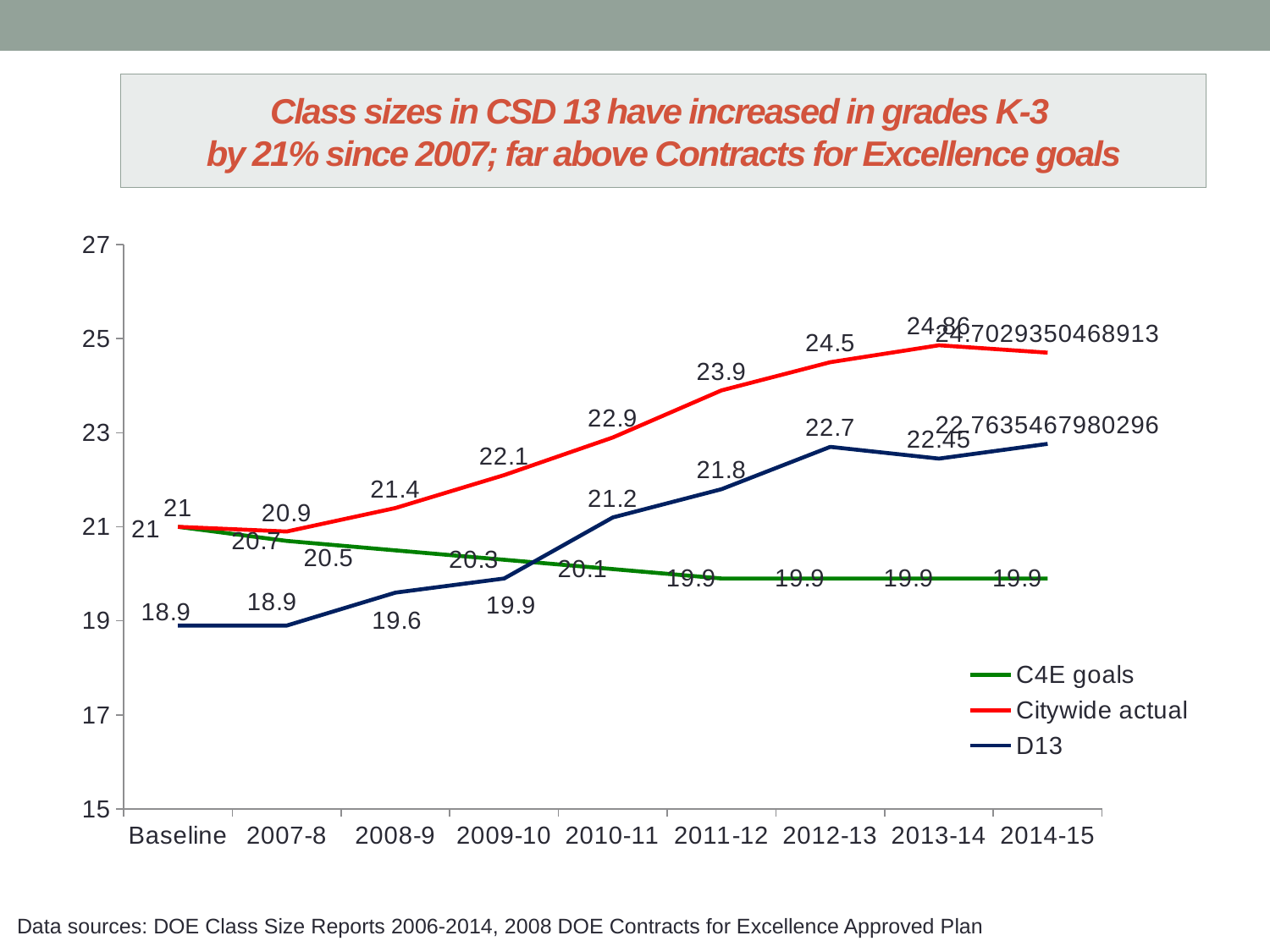
What kind of chart is shown on the slide? line chart Is the D13 value for 2009-10 greater or less than 21? less How many points are plotted along the x axis for each series? 9 What is the D13 value for 2010-11? 21.2 At which point on the x axis is the C4E goals value highest? Baseline What colour is the Citywide actual line? red In 2011-12, which is larger: the D13 value or the Citywide actual value? Citywide actual What is the Citywide actual value for 2012-13? 24.5 What is the difference between the Citywide actual value and the C4E goals value in 2012-13? 4.6 What is the C4E goals value for 2008-9? 20.5 Do the C4E goals values rise or fall from Baseline to 2014-15? fall How many series does the legend list? 3